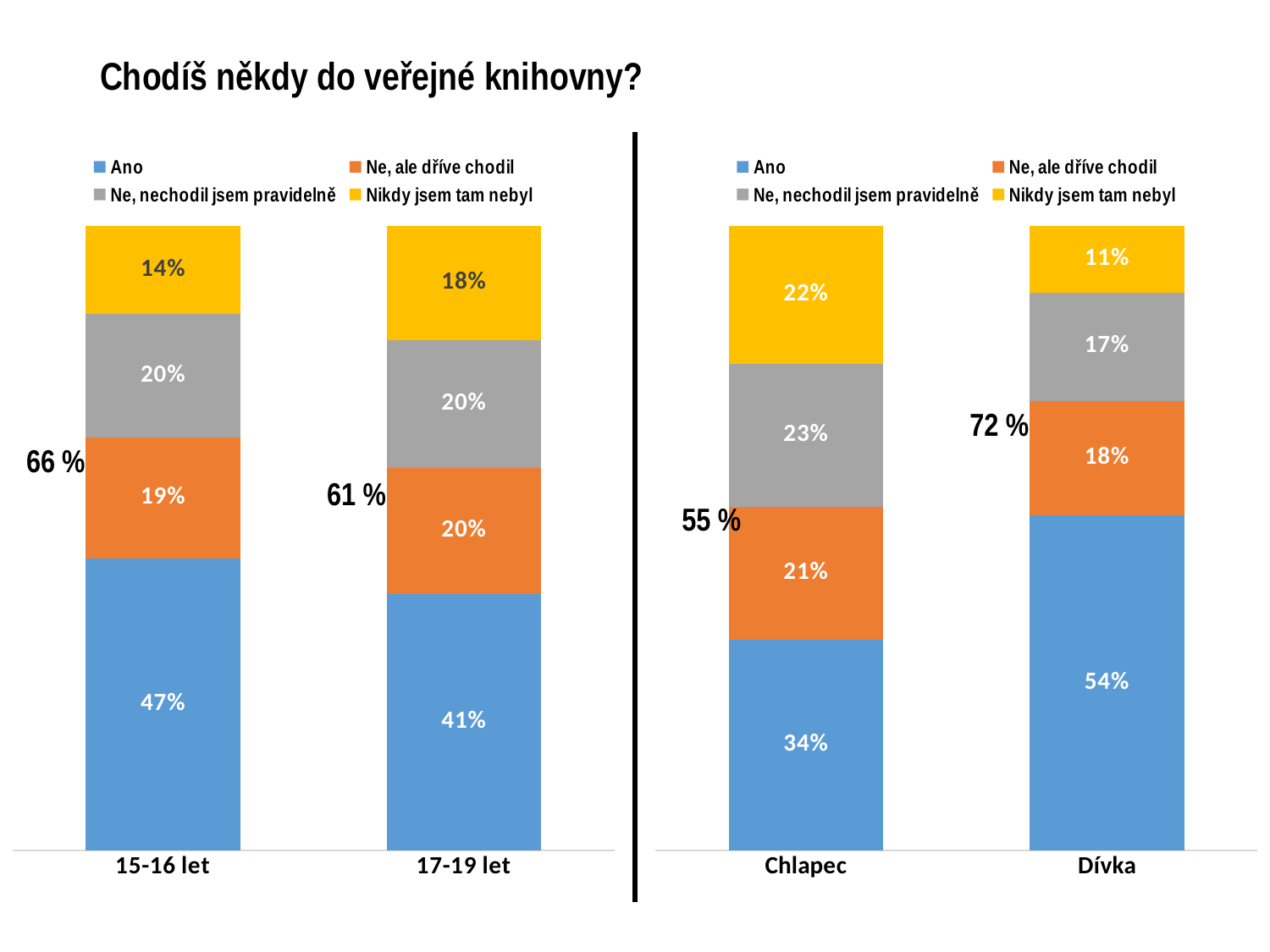
In the right chart (Chlapec / Dívka), what is the value of "Ne, nechodil jsem pravidelně" for Chlapec? 23% In the left chart (15-16 let / 17-19 let), what is the value of "Ano" for 15-16 let? 47% How many series does the legend of the right chart (Chlapec / Dívka) list? 4 In the left chart (15-16 let / 17-19 let), which category has the lower value for "Ano"? 17-19 let In the right chart (Chlapec / Dívka), what is the difference between the "Ano" values for Dívka and Chlapec? 20% In the left chart (15-16 let / 17-19 let), what is the value of "Nikdy jsem tam nebyl" for 17-19 let? 18% What kind of chart is the right chart (Chlapec / Dívka)? Stacked bar chart In the right chart (Chlapec / Dívka), what is the value of "Ano" for Dívka? 54% In the left chart (15-16 let / 17-19 let), is the "Nikdy jsem tam nebyl" value larger for 15-16 let or for 17-19 let? 17-19 let How many categories are shown on the x axis of the left chart (15-16 let / 17-19 let)? 2 In the right chart (Chlapec / Dívka), which category has the higher value for "Ano"? Dívka In the right chart (Chlapec / Dívka), what is the combined total of "Ano" and "Ne, ale dříve chodil" for Chlapec? 55%